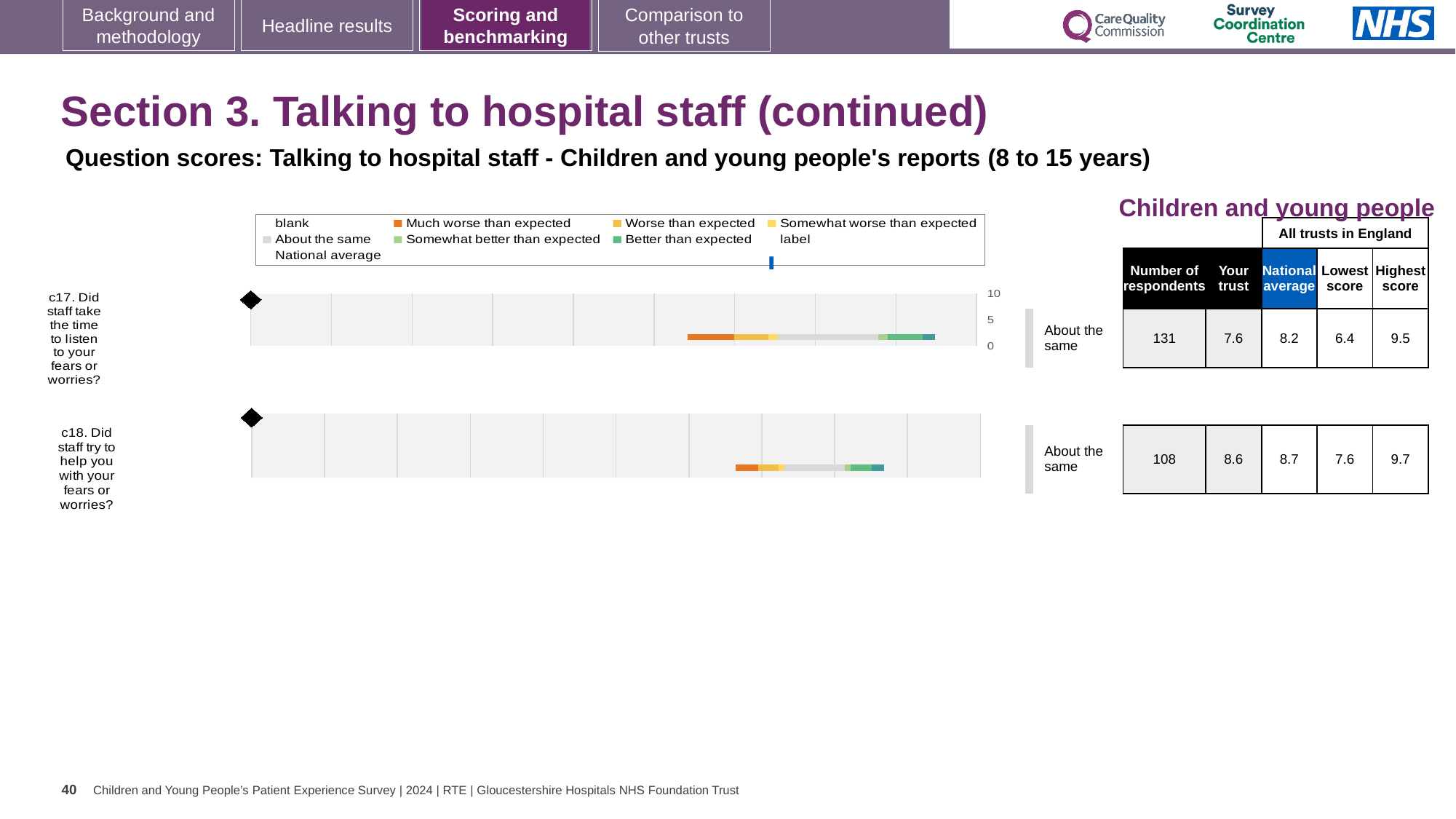
What is the lowest score among all trusts in England for c17? 6.4 How many respondents answered c18 (Did staff try to help you with your fears or worries?)? 108 How many questions are plotted on the slide? 2 What benchmark category label is shown next to the c17 bar? About the same What kind of chart is used to show the benchmarking for questions c17 and c18? bar chart How many more respondents answered c17 than c18? 23 What is the 'Your trust' score for c17 (Did staff take the time to listen to your fears or worries?)? 7.6 Which question has the higher 'Your trust' score, c17 or c18? c18 What is the highest score among all trusts in England for c18? 9.7 What is the national average score for c17? 8.2 What is the difference between the highest and lowest scores for c17? 3.1 What is the difference between the national average and the 'Your trust' score for c18? 0.1